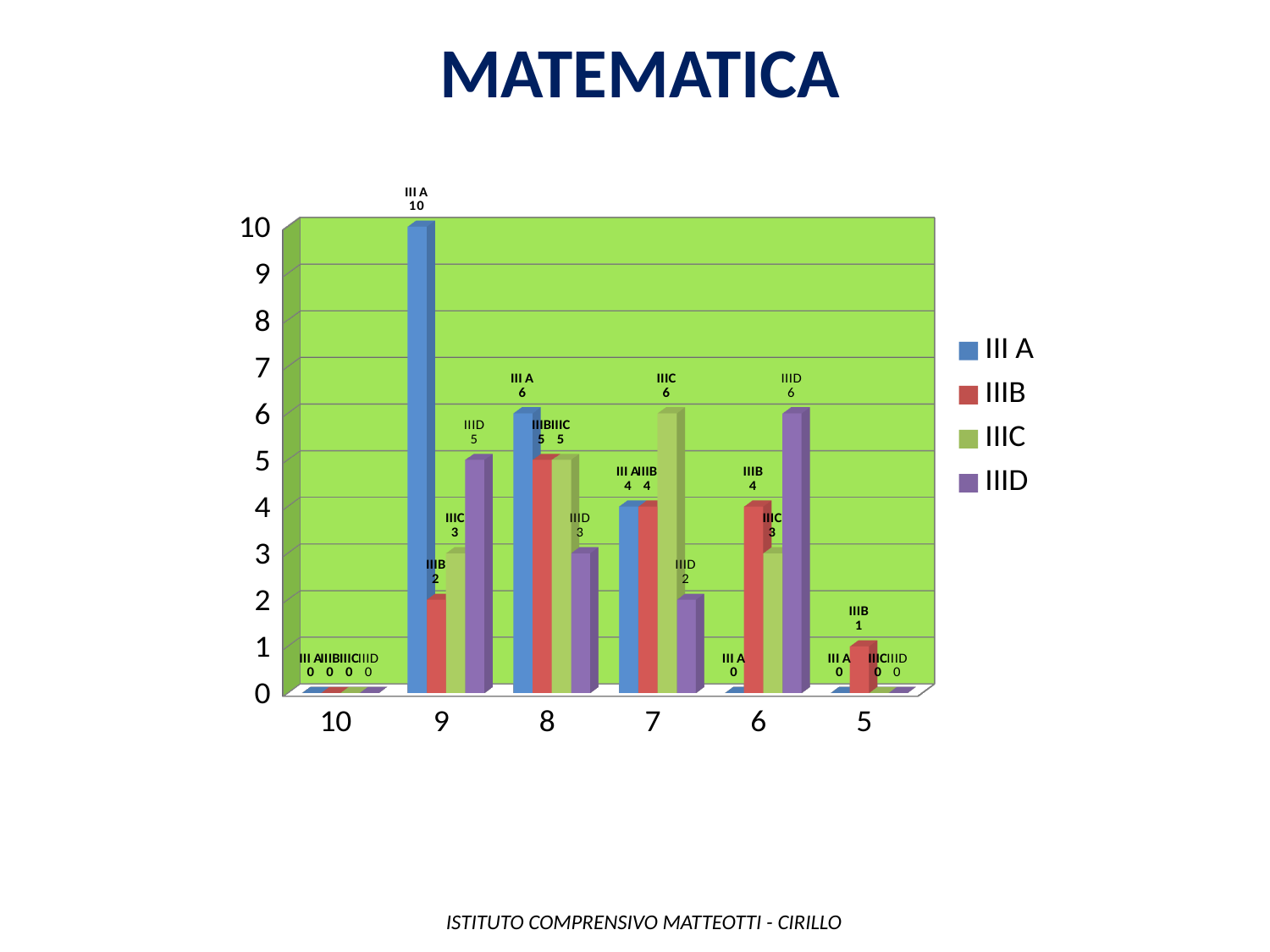
What is the difference between III A and IIID in category 8? 3 What is the value for III A in category 9? 10 What is the total of all four series in category 9? 20 What is the title of the chart? MATEMATICA What is the value for IIID in category 6? 6 What is the value for IIIB in category 5? 1 What type of chart is shown on the slide? bar chart How many categories are shown on the x axis? 6 Which series has the highest value in category 7? IIIC In category 6, which is larger: IIIB or IIIC? IIIB Which series has the lowest value in category 9? IIIB How many series does the legend list? 4